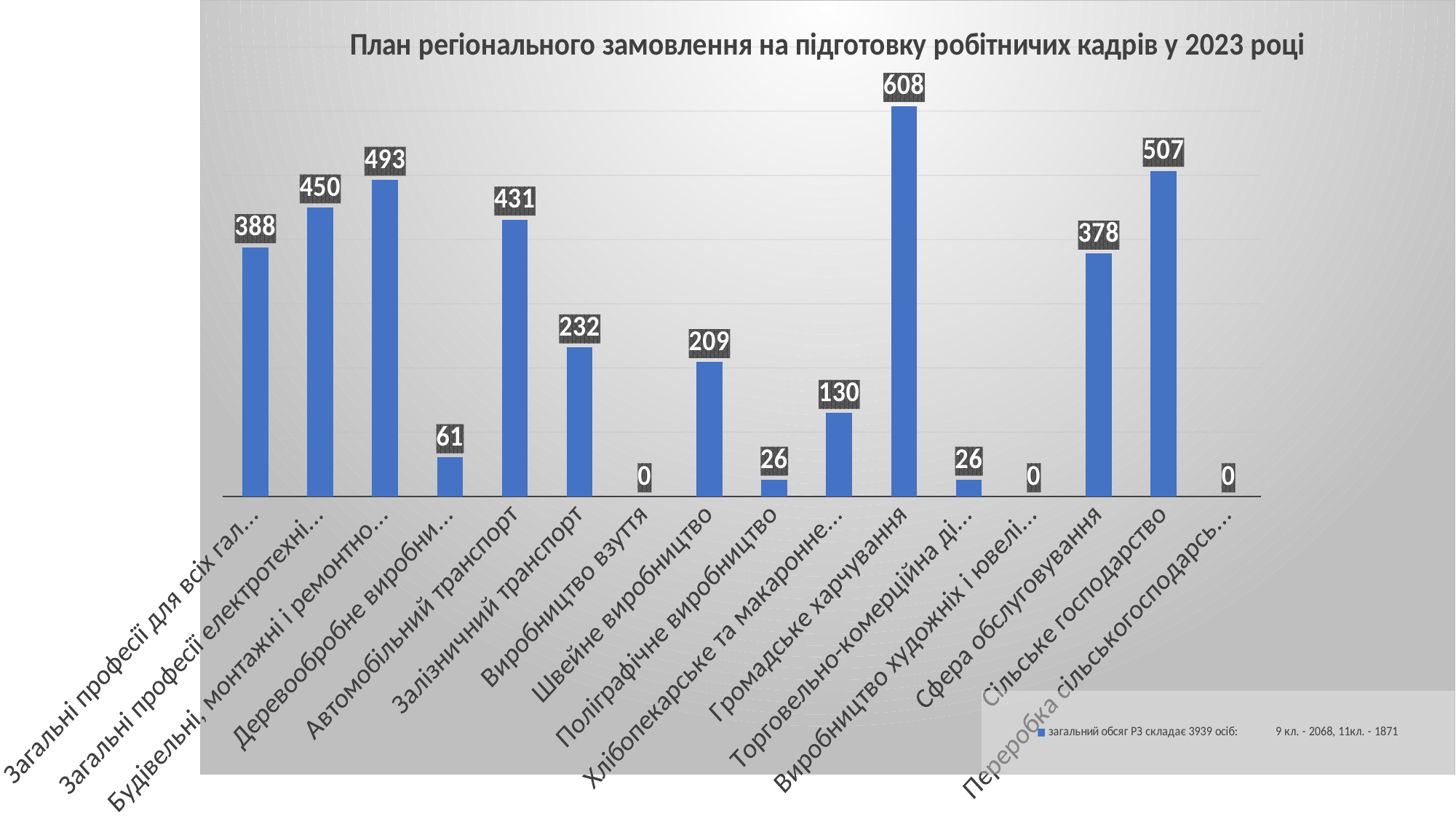
What is the value for Сільське господарство? 507 Which category has the highest value? Громадське харчування What is the title of the chart? План регіонального замовлення на підготовку робітничих кадрів у 2023 році What is the difference between the values for Сільське господарство and Сфера обслуговування? 129 What is the value for Виробництво взуття? 0 What is the value for Залізничний транспорт? 232 What is the value for Швейне виробництво? 209 What is the value for Поліграфічне виробництво? 26 Which is larger, the value for Автомобільний транспорт or the value for Залізничний транспорт? Автомобільний транспорт How many categories are shown on the x axis? 16 What is the value for Громадське харчування? 608 What kind of chart is shown on the slide? Bar chart